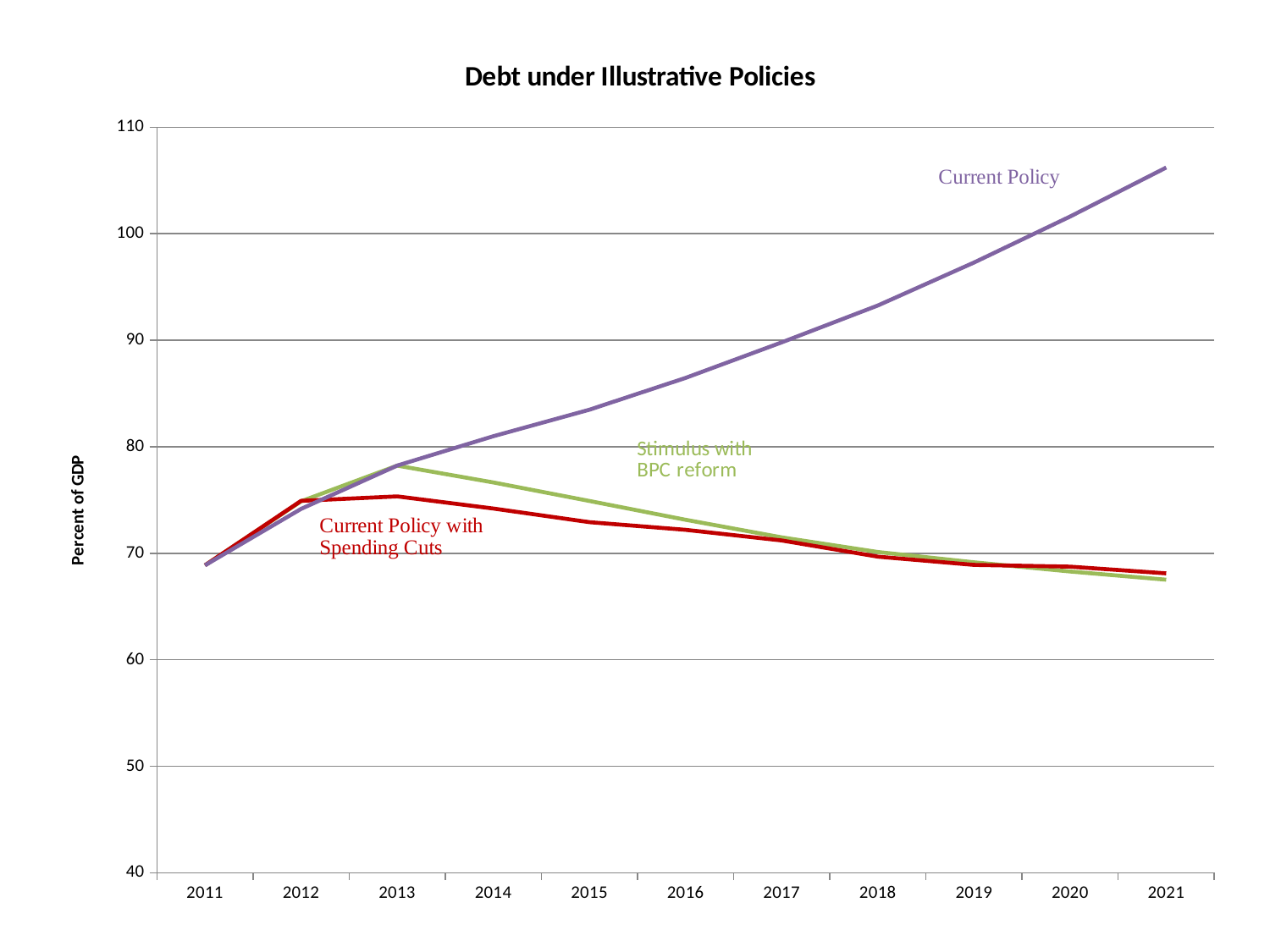
How many years are shown on the x axis of the chart? 11 Which policy line has the highest value in 2021? Current Policy Is the value for Current Policy with Spending Cuts in 2013 greater or less than 80? less Is the value for Current Policy in 2021 greater or less than 100? greater What kind of chart is shown on the slide? line chart How many policy lines are plotted on the chart? 3 In 2021, which is higher: Current Policy or Stimulus with BPC reform? Current Policy Is the value for Current Policy in 2016 greater or less than 90? less What is the label on the vertical axis of the chart? Percent of GDP Does the Stimulus with BPC reform line rise or fall from 2013 to 2021? fall Does the Current Policy line rise or fall from 2011 to 2021? rise